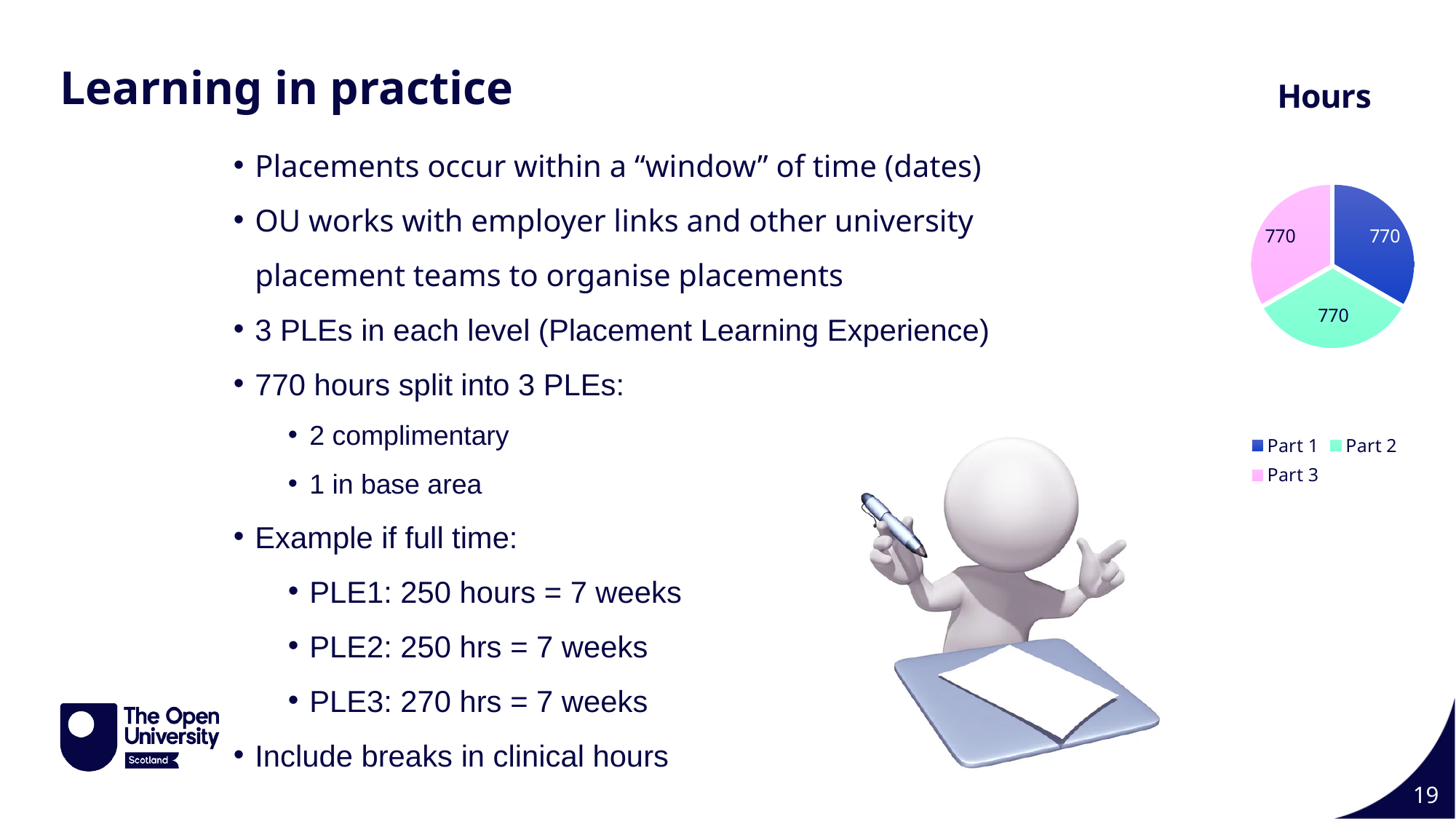
What is the difference between the values for Part 1 and Part 3? 0 What share of the pie does Part 2 represent? one third What is the value shown for Part 3 in the pie chart? 770 How many slices does the pie chart have? 3 What is the value shown for Part 2 in the pie chart? 770 What kind of chart is shown on the slide? pie chart How many entries does the chart legend list? 3 What is the value shown for Part 1 in the pie chart? 770 Which colour represents Part 3 in the pie chart? pink What is the total of all three slices in the pie chart? 2310 What is the title of the chart? Hours